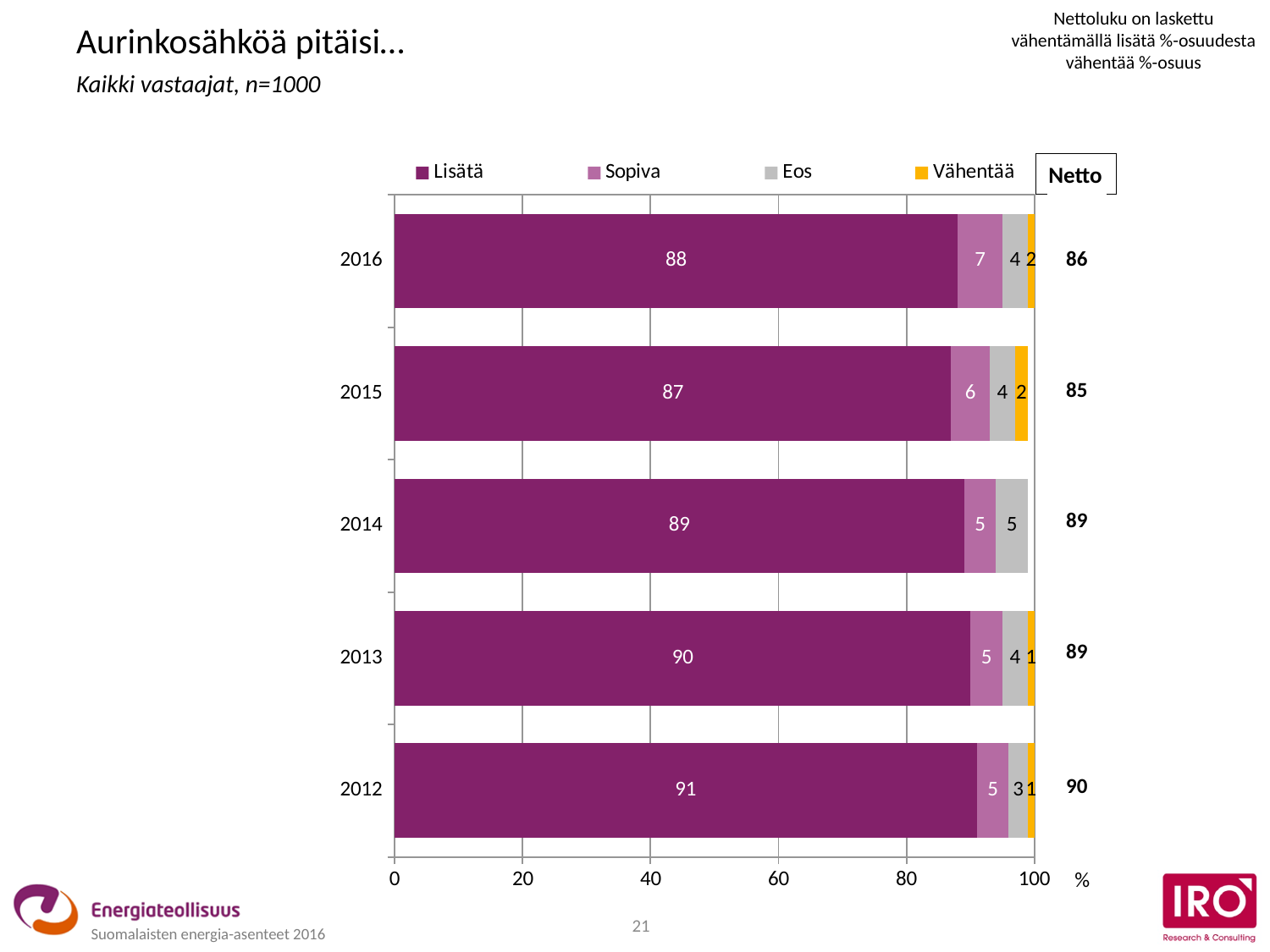
What is the Vähentää value for 2013? 1 What kind of chart is shown on the slide? Stacked bar chart How many series does the legend list? 4 What is the Netto value shown for 2012? 90 Which year has the highest Lisätä value? 2012 What is the Lisätä value for 2016? 88 Which year has the larger Sopiva value, 2016 or 2014? 2016 What is the Eos value for 2014? 5 What is the Sopiva value for 2015? 6 Which year has the lowest Lisätä value? 2015 What is the difference between the Lisätä values for 2012 and 2016? 3 How many years are shown on the chart? 5